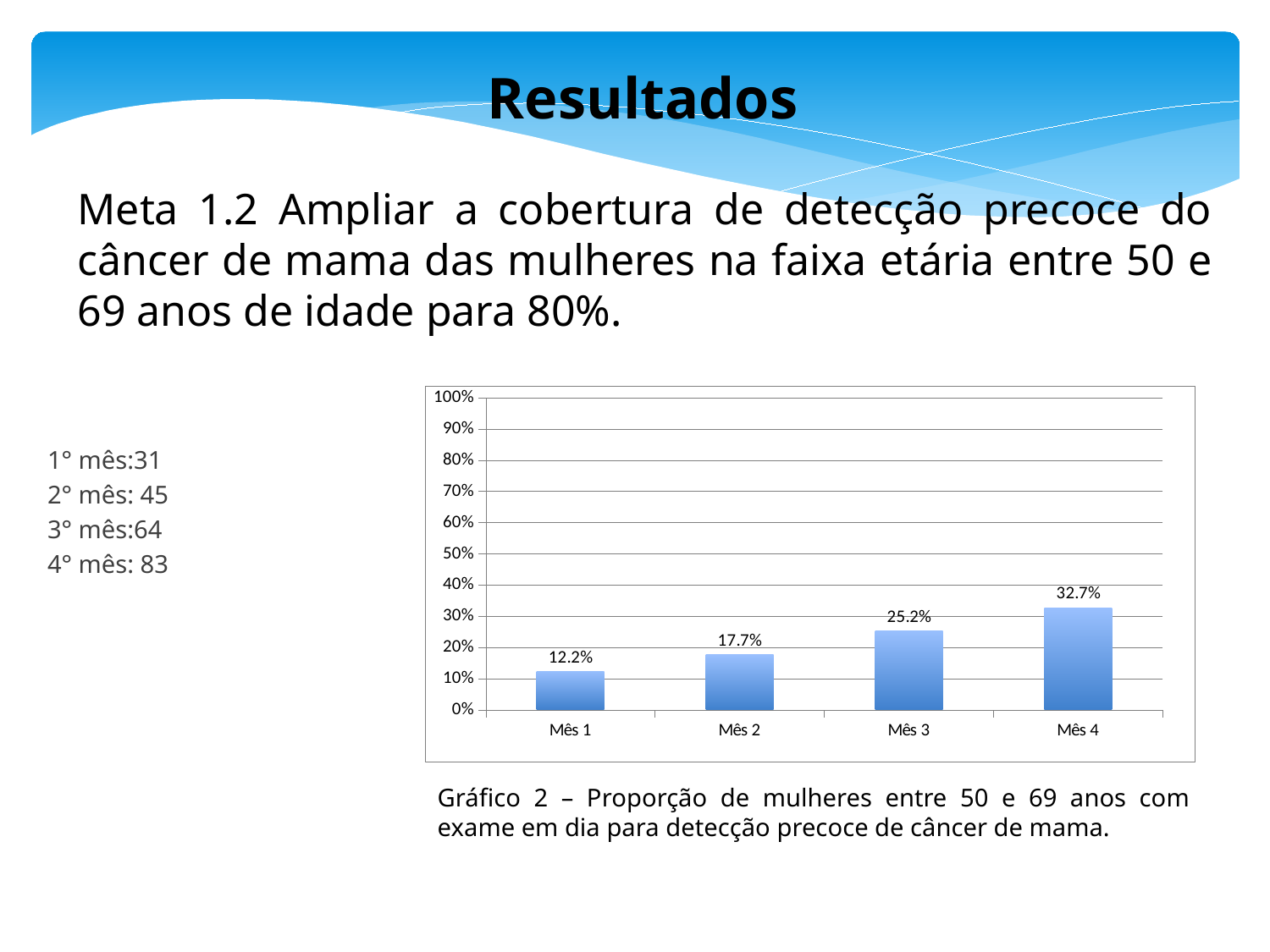
What is the difference between the values for Mês 4 and Mês 1? 20.5% What is the value for Mês 1? 12.2% What is the value for Mês 3? 25.2% What kind of chart is shown on the slide? bar chart Is the value for Mês 4 greater or less than 40%? less What is the difference between the values for Mês 2 and Mês 1? 5.5% How many months are shown on the x axis? 4 Do the values rise or fall from Mês 1 to Mês 4? rise What is the value for Mês 4? 32.7% Which month has the highest value? Mês 4 Which month has the lowest value? Mês 1 Which is larger, the value for Mês 2 or the value for Mês 3? Mês 3